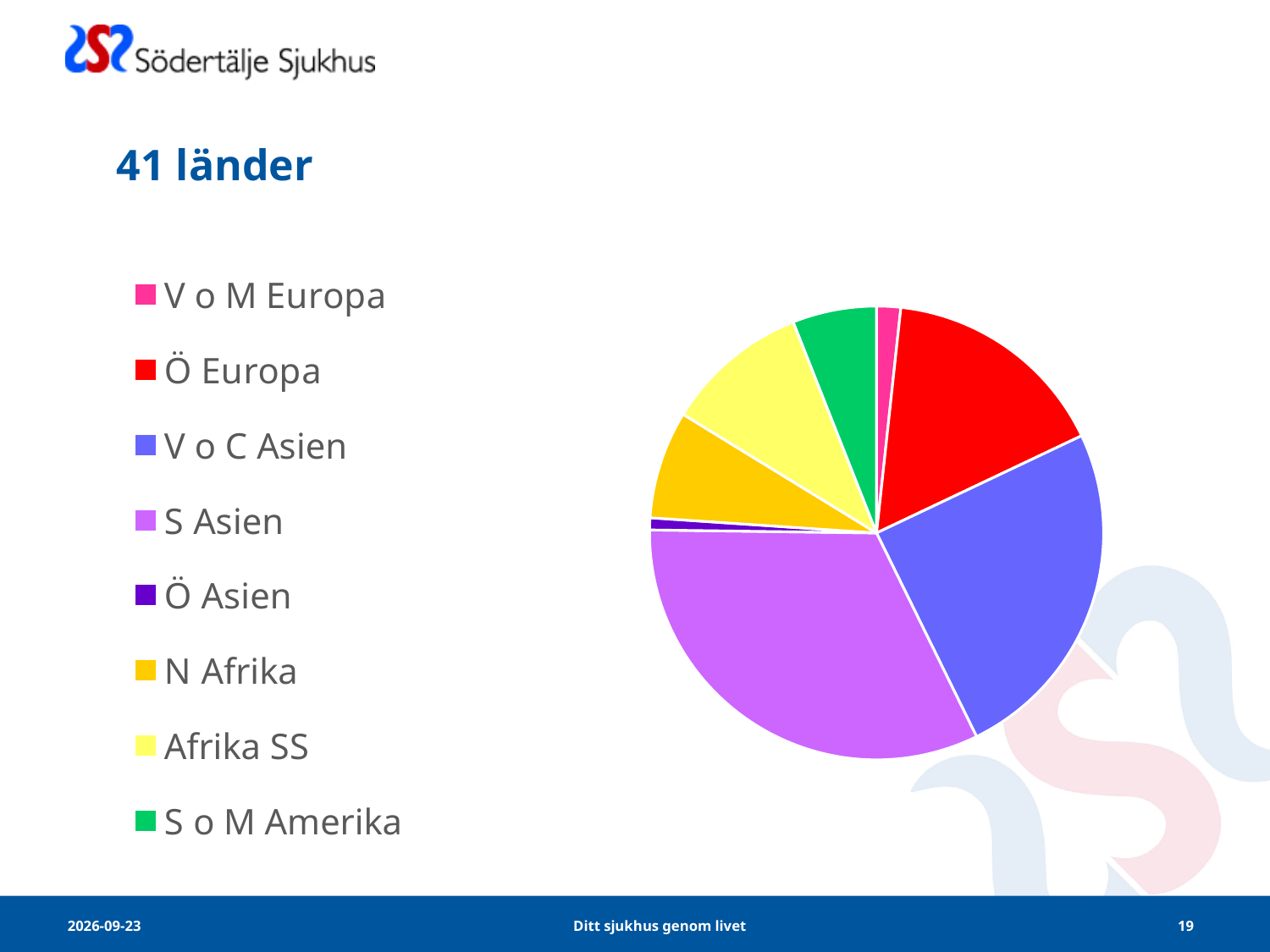
Which slice is larger, V o M Europa or Ö Asien? V o M Europa What is the title of the slide containing the pie chart? 41 länder Which slice is larger, Ö Europa or Afrika SS? Ö Europa What kind of chart is shown on the slide? pie chart Which slice is larger, S Asien or Ö Europa? S Asien Which category is shown in red in the pie chart? Ö Europa How many categories (slices) does the pie chart have? 8 Which category is listed last in the legend of the pie chart? S o M Amerika Which category has the largest slice of the pie chart? S Asien Which category has the smallest slice of the pie chart? Ö Asien